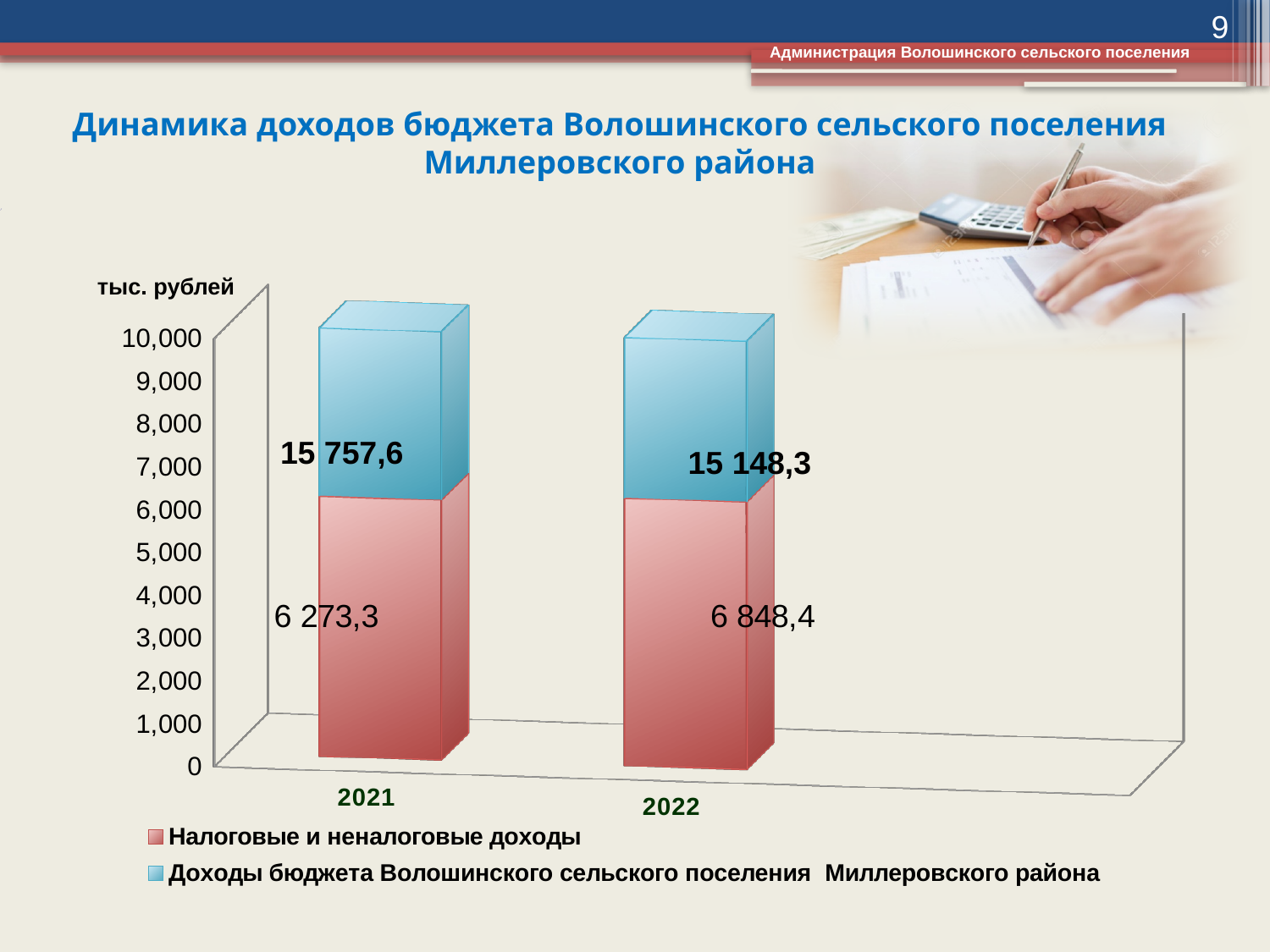
What is the value of 'Налоговые и неналоговые доходы' for 2021? 6 273,3 By how much did 'Налоговые и неналоговые доходы' change from 2021 to 2022? 575,1 How many years are shown on the x axis of the chart? 2 What is the value of 'Налоговые и неналоговые доходы' for 2022? 6 848,4 Which year has the larger value for 'Налоговые и неналоговые доходы', 2021 or 2022? 2022 What is the value of 'Доходы бюджета Волошинского сельского поселения Миллеровского района' for 2022? 15 148,3 What unit is indicated for the chart's vertical axis? тыс. рублей How many series does the chart legend list? 2 What is the difference between the 2021 and 2022 values of 'Доходы бюджета Волошинского сельского поселения Миллеровского района'? 609,3 What type of chart is shown on the slide? Bar chart Which year has the larger value for 'Доходы бюджета Волошинского сельского поселения Миллеровского района', 2021 or 2022? 2021 What is the value of 'Доходы бюджета Волошинского сельского поселения Миллеровского района' for 2021? 15 757,6